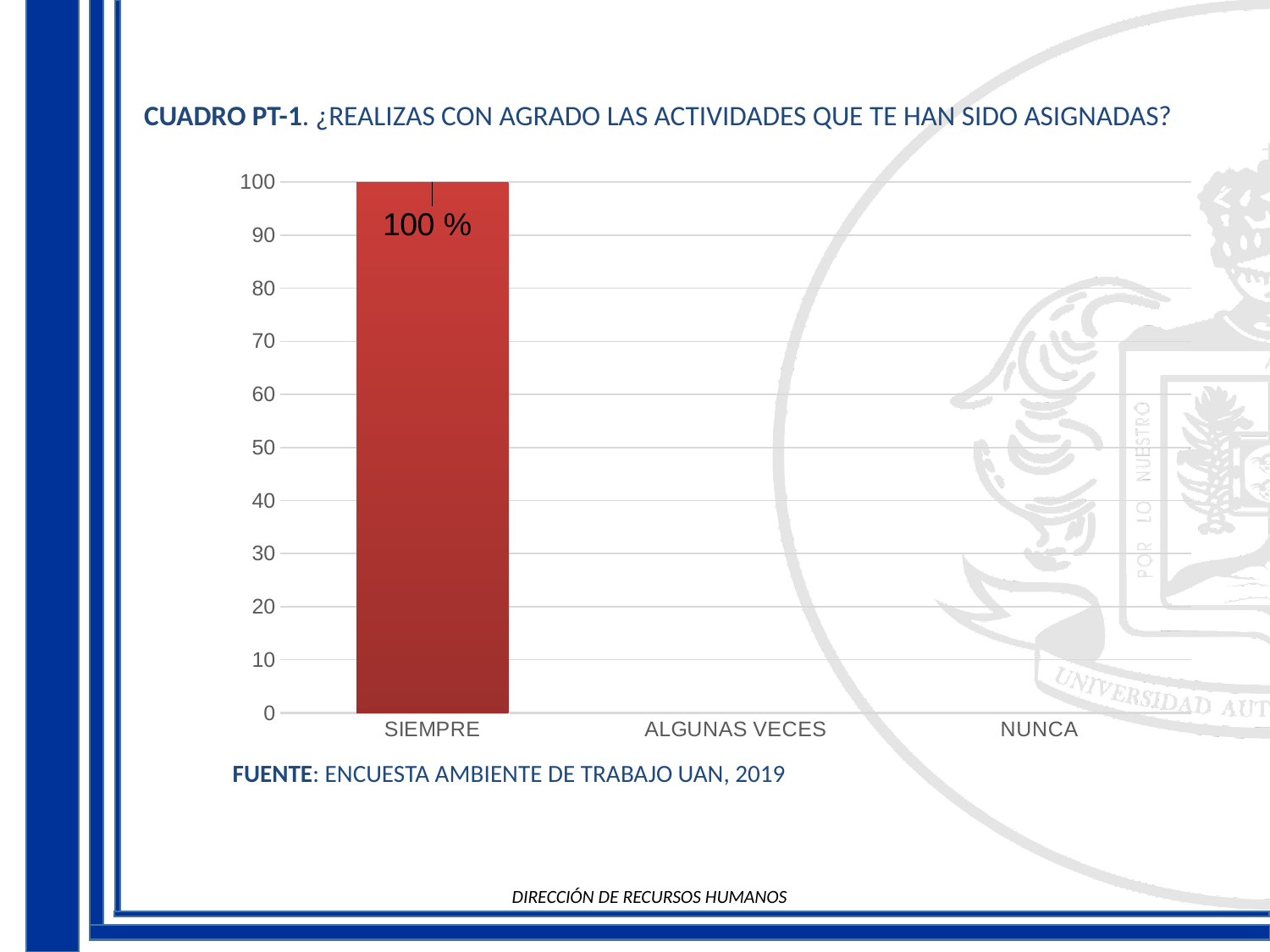
Do the values rise or fall from SIEMPRE to NUNCA along the x axis? fall Which category has the highest value? SIEMPRE What is the source cited below the chart? ENCUESTA AMBIENTE DE TRABAJO UAN, 2019 What is the value for SIEMPRE? 100 % How many categories are shown on the x axis? 3 What is the title of the chart? CUADRO PT-1. ¿REALIZAS CON AGRADO LAS ACTIVIDADES QUE TE HAN SIDO ASIGNADAS? Which is larger, the value for SIEMPRE or the value for NUNCA? SIEMPRE What is the maximum value shown on the y axis? 100 What kind of chart is shown on the slide? bar chart Which is larger, the value for SIEMPRE or the value for ALGUNAS VECES? SIEMPRE Is the value for SIEMPRE greater or less than 90? greater